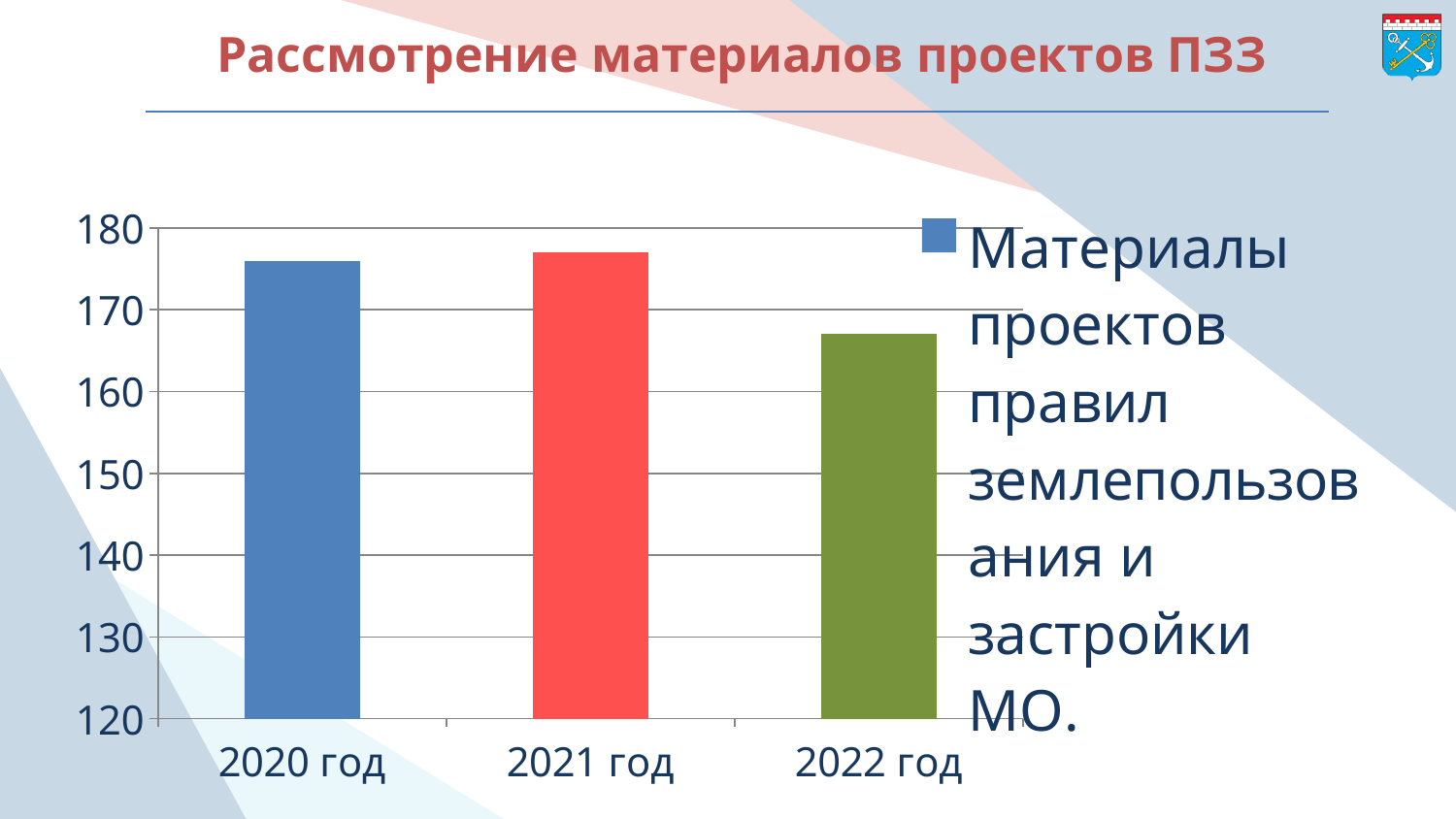
Which year has the lowest bar in the chart? 2022 год Is the value for 2020 год greater or less than 170? greater What colour is the bar for 2021 год? red Is the value for 2021 год greater or less than 170? greater How many series does the chart's legend list? 1 Which is larger, the value for 2020 год or the value for 2022 год? 2020 год What kind of chart is shown on the slide? bar chart Is the value for 2022 год greater or less than 160? greater How many categories (years) are shown on the x axis of the chart? 3 Does the value rise or fall from 2021 год to 2022 год? fall What is the title of the slide containing the chart? Рассмотрение материалов проектов ПЗЗ